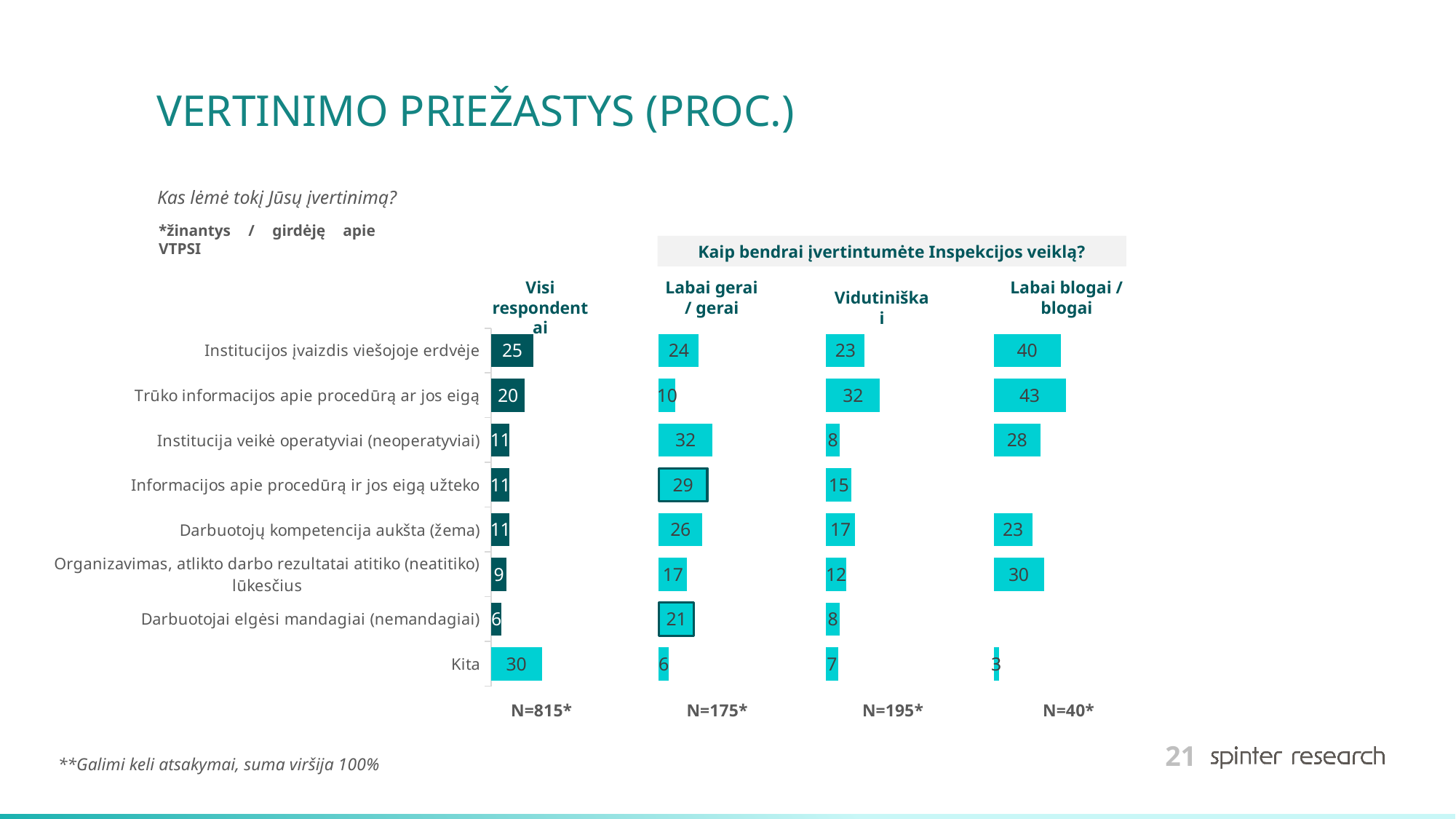
In the "Labai blogai / blogai" chart, what is the value for "Trūko informacijos apie procedūrą ar jos eigą"? 43 In the "Vidutiniškai" chart, what is the difference between "Trūko informacijos apie procedūrą ar jos eigą" and "Institucijos įvaizdis viešojoje erdvėje"? 9 What is the sample size (N) shown under the "Labai blogai / blogai" chart? N=40* In the "Labai gerai / gerai" chart, which category has the highest value? Institucija veikė operatyviai (neoperatyviai) In the "Visi respondentai" chart, what is the value for "Institucijos įvaizdis viešojoje erdvėje"? 25 In the "Labai gerai / gerai" chart, what is the value for "Kita"? 6 In the "Vidutiniškai" chart, what is the value for "Darbuotojų kompetencija aukšta (žema)"? 17 How many categories are shown in the "Visi respondentai" chart? 8 In the "Labai blogai / blogai" chart, which category has the highest value? Trūko informacijos apie procedūrą ar jos eigą In the "Labai gerai / gerai" chart, which is larger: "Informacijos apie procedūrą ir jos eigą užteko" or "Darbuotojų kompetencija aukšta (žema)"? Informacijos apie procedūrą ir jos eigą užteko In the "Visi respondentai" chart, which category has the lowest value? Darbuotojai elgėsi mandagiai (nemandagiai) What kind of chart is used on this slide? Bar chart